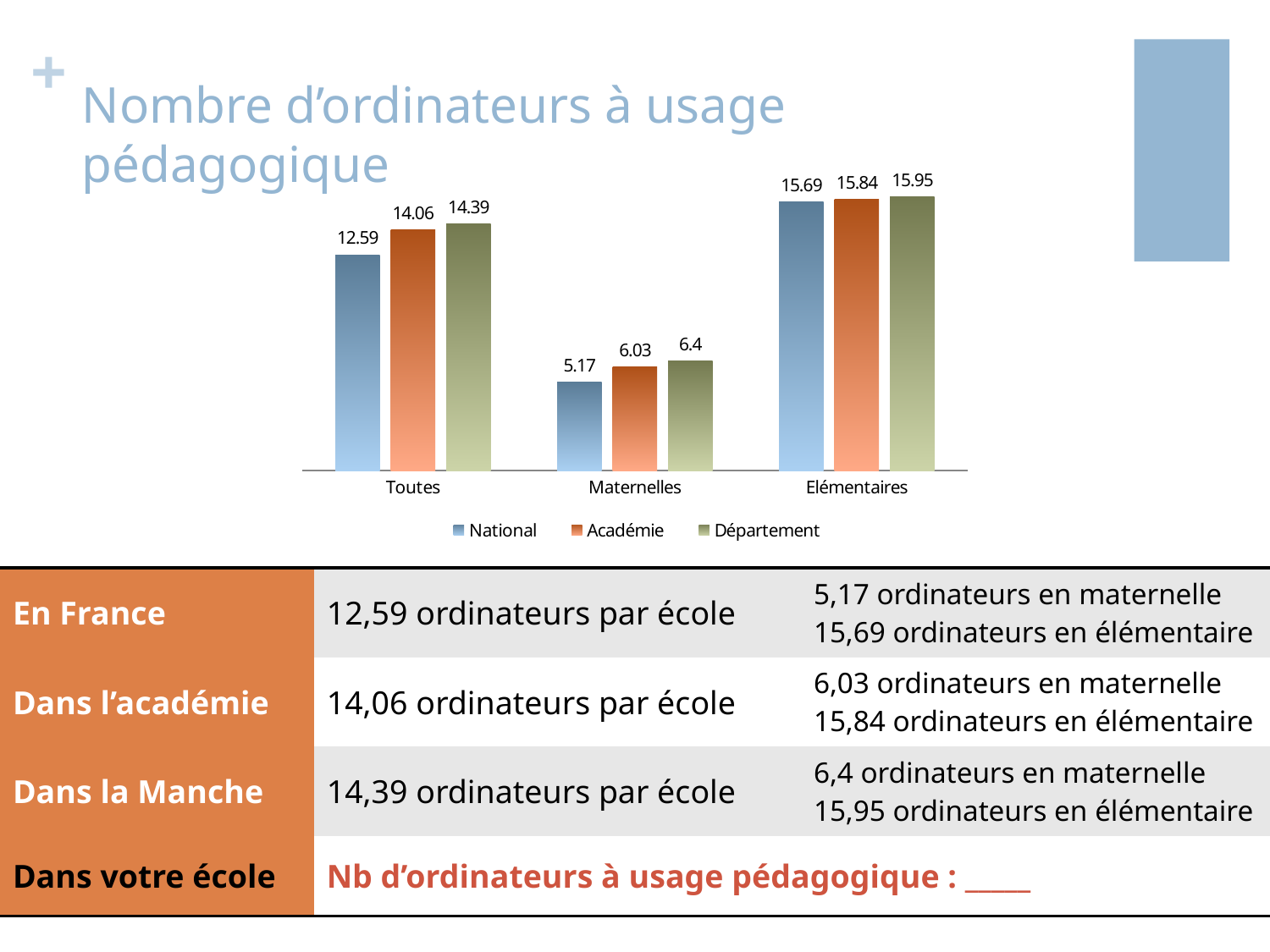
Which is larger in the Elémentaires category, National or Département? Département How many series does the legend list? 3 How many categories are shown on the x axis? 3 What is the value for Département in the Maternelles category? 6.4 Which series is shown in orange in the legend? Académie What is the value for Académie in the Elémentaires category? 15.84 Which series has the highest value in the Toutes category? Département What is the value for National in the Toutes category? 12.59 What kind of chart is shown on the slide? Bar chart What is the difference between the Académie and National values in the Maternelles category? 0.86 What is the difference between the Département and National values in the Toutes category? 1.8 Which category has the lowest value for the National series? Maternelles